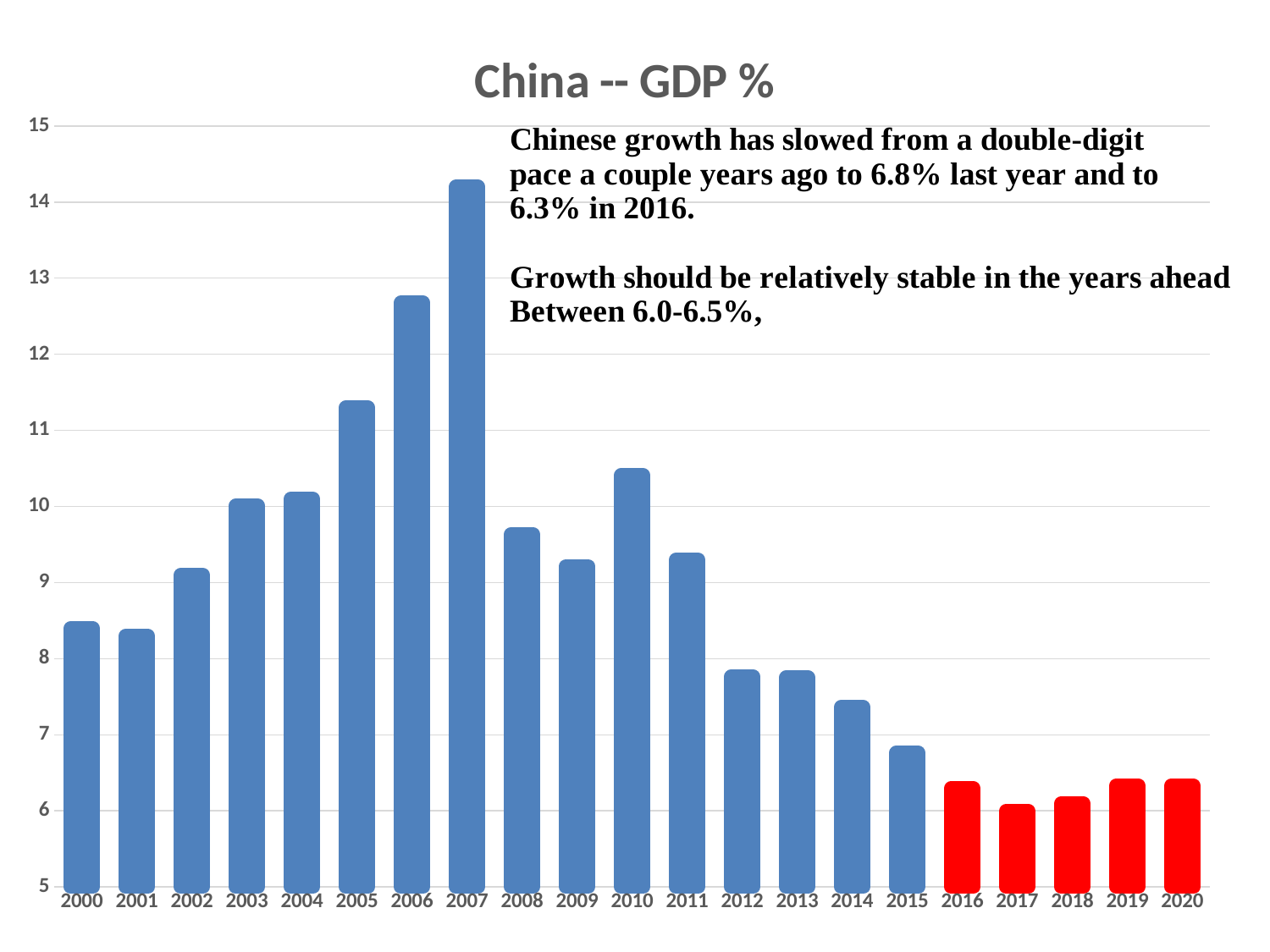
What kind of chart is shown on the slide? bar chart Is the value for 2006 greater or less than 12? greater Is the value for 2007 greater or less than 14? greater Is the value for 2015 greater or less than 7? less How many years are shown on the x axis of the chart? 21 Which is larger, the value for 2010 or the value for 2009? 2010 Do the values rise or fall from 2007 to 2015? fall Which year has the highest bar in the chart? 2007 Which years are shown with red bars instead of blue? 2016 to 2020 What is the title of the chart? China -- GDP %